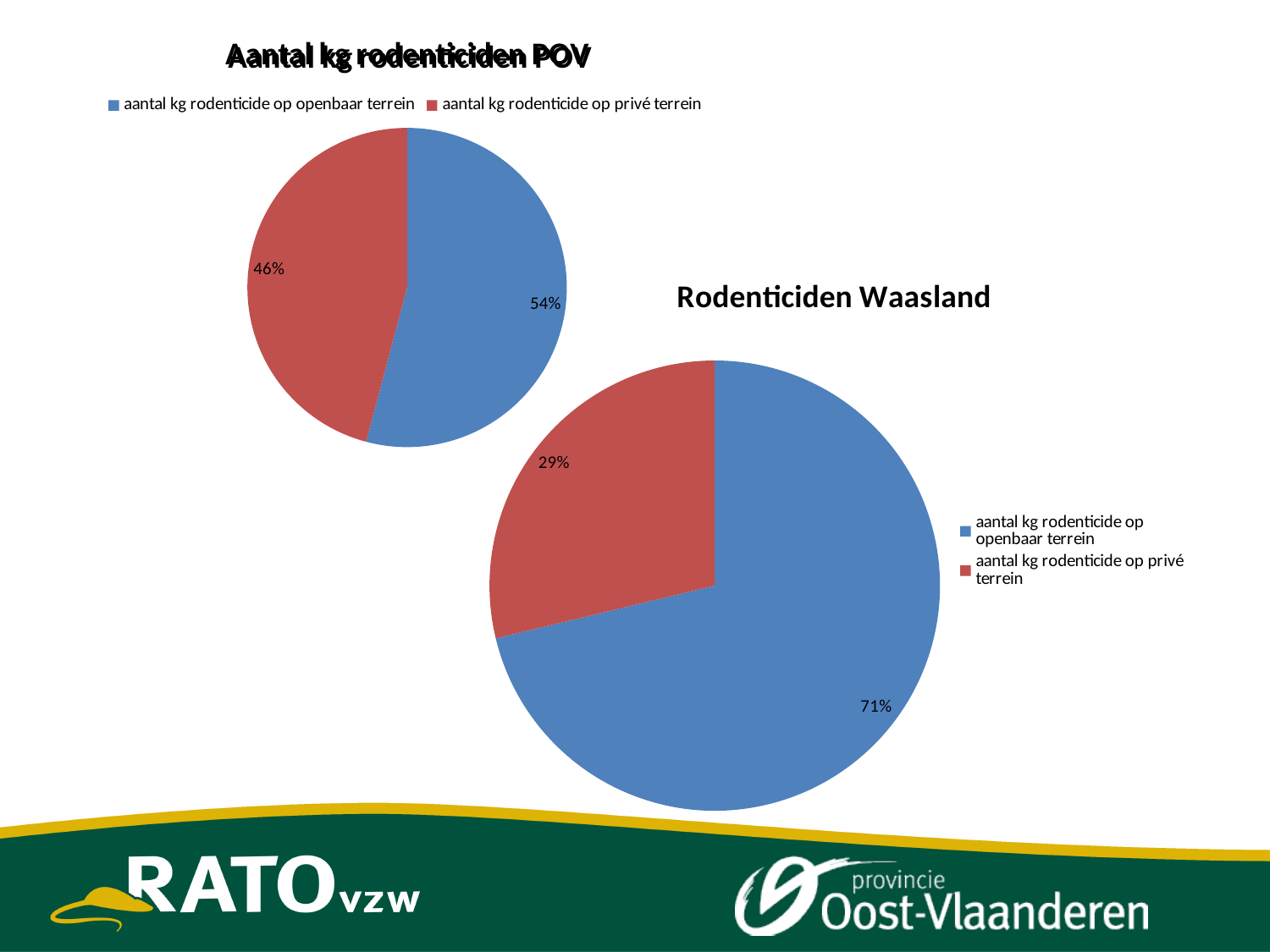
In the 'Aantal kg rodenticiden POV' chart, which slice is the smallest? aantal kg rodenticide op privé terrein In the 'Aantal kg rodenticiden POV' chart, what share is 'aantal kg rodenticide op privé terrein'? 46% In the 'Rodenticiden Waasland' chart, which slice is the largest? aantal kg rodenticide op openbaar terrein In the 'Aantal kg rodenticiden POV' chart, what share is 'aantal kg rodenticide op openbaar terrein'? 54% In the 'Rodenticiden Waasland' chart, what share is 'aantal kg rodenticide op openbaar terrein'? 71% Which chart has the larger share for 'aantal kg rodenticide op privé terrein', 'Aantal kg rodenticiden POV' or 'Rodenticiden Waasland'? Aantal kg rodenticiden POV In the 'Aantal kg rodenticiden POV' chart, what is the difference in percentage points between the openbaar terrein slice and the privé terrein slice? 8 What kind of chart is 'Rodenticiden Waasland'? pie chart How many slices does the 'Aantal kg rodenticiden POV' chart have? 2 In the 'Rodenticiden Waasland' chart, what is the difference in percentage points between the openbaar terrein slice and the privé terrein slice? 42 In the 'Rodenticiden Waasland' chart, what colour is the 'aantal kg rodenticide op privé terrein' slice? red